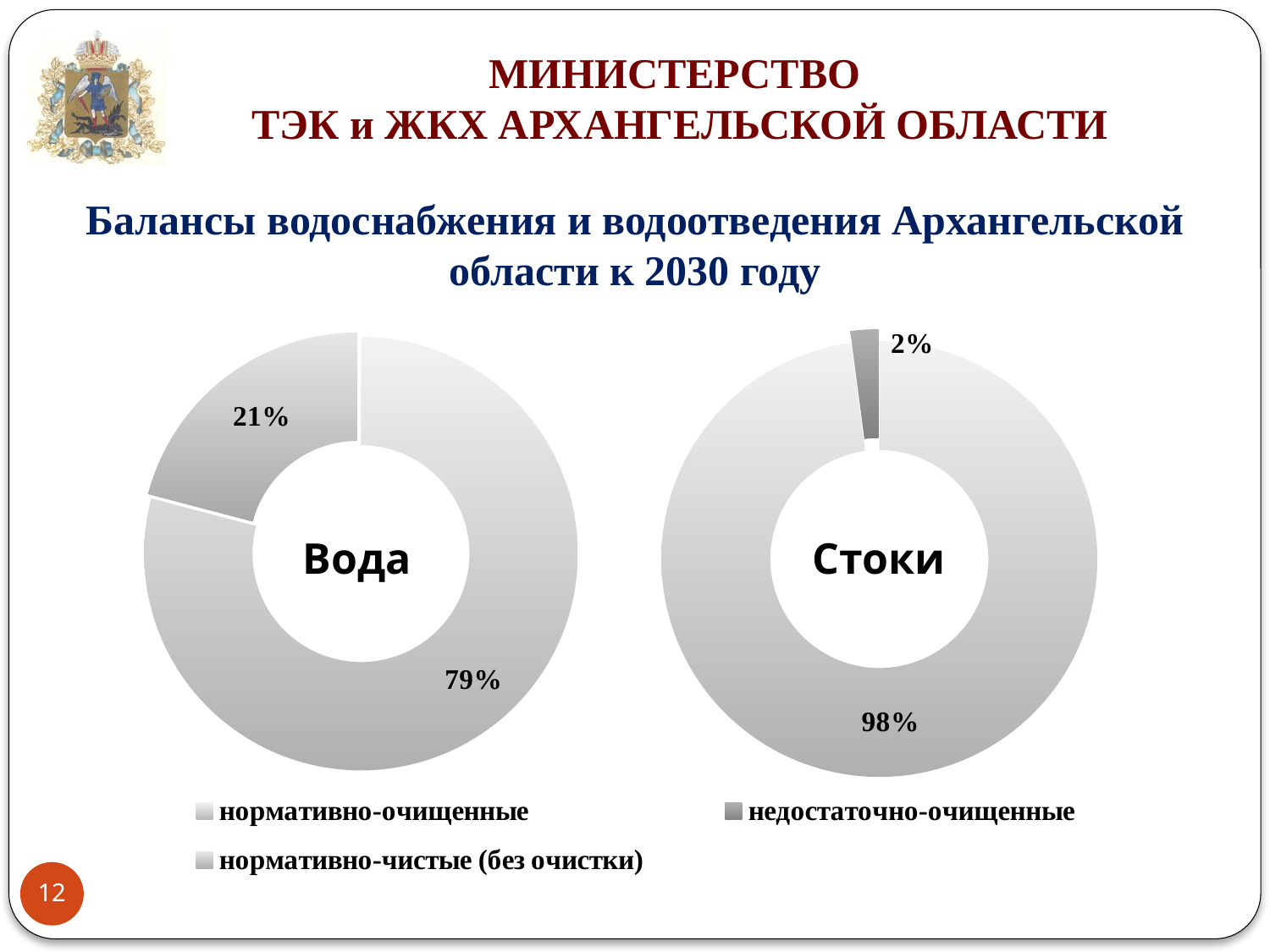
In the "Вода" chart, what is the value of the smallest slice? 21% In the "Стоки" chart, what is the difference between the two slices (98% and 2%)? 96 percentage points How many slices does the "Вода" chart have? 2 In the "Стоки" chart, what is the value of the largest slice? 98% In the "Стоки" chart, what is the value of the smallest slice? 2% In the "Вода" chart, what is the value of the largest slice? 79% How many slices does the "Стоки" chart have? 2 What kind of chart is used for the "Вода" chart? Doughnut (pie) chart What label is shown in the centre of the left doughnut chart? Вода In the "Вода" chart, what is the difference between the two slices (79% and 21%)? 58 percentage points Which chart has the larger dominant slice, "Вода" (79%) or "Стоки" (98%)? Стоки How many entries does the legend below the charts list? 3